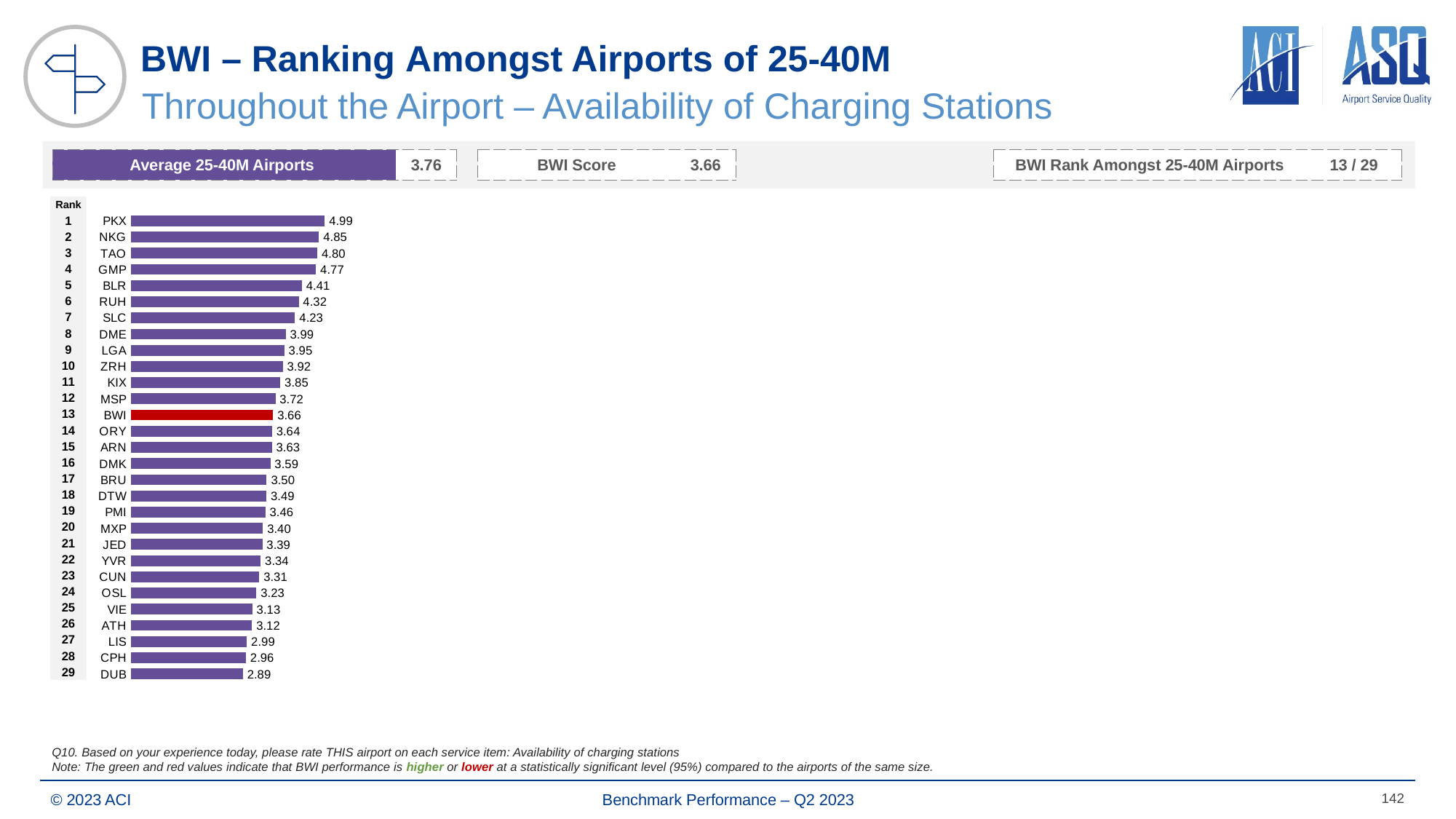
Which airport has the highest score in the chart? PKX What is the difference between the scores of MSP and BWI? 0.06 Do the scores rise or fall as you go down the ranking from rank 1 to rank 29? Fall Which airport has the lowest score in the chart? DUB How many airports are ranked in the bar chart? 29 Which has a higher score, SLC or LGA? SLC What is the score for BWI in the bar chart? 3.66 What is the score for PKX? 4.99 What is the difference between the scores of PKX and DUB? 2.10 What kind of chart is shown on the slide? Bar chart Which airport's bar is coloured red in the chart? BWI What is the score for DUB? 2.89